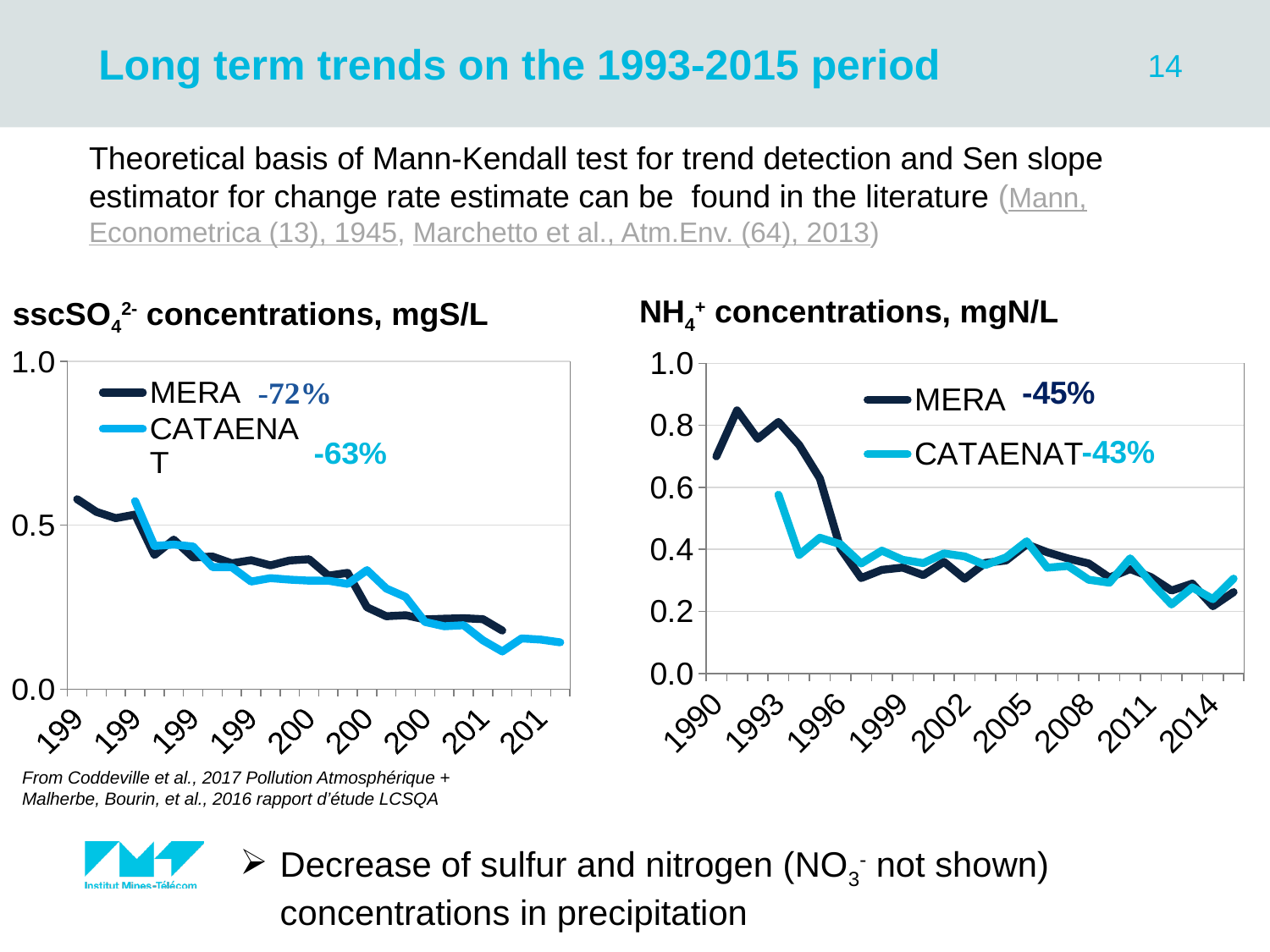
In the sscSO4 2- concentrations chart, what percentage change is printed next to the MERA series? -72% What kind of chart is the sscSO4 2- concentrations chart on the left? line chart What unit is given in the title of the chart on the right? mgN/L In the sscSO4 2- concentrations chart, what percentage change is printed next to the CATAENAT series? -63% In the NH4+ concentrations chart, what percentage change is printed next to the MERA series? -45% In the sscSO4 2- concentrations chart, do the CATAENAT values generally rise or fall along the x axis? fall In the NH4+ concentrations chart, is the MERA value in 2014 greater or less than 0.4? less In the NH4+ concentrations chart, do the MERA values generally rise or fall from 1990 to 2014? fall How many series does the legend of the NH4+ concentrations chart list? 2 In the sscSO4 2- concentrations chart, is the MERA value at the start of the series greater or less than 0.5? greater In the NH4+ concentrations chart, is the MERA value in 1990 greater or less than 0.6? greater In the NH4+ concentrations chart, what percentage change is printed next to the CATAENAT series? -43%